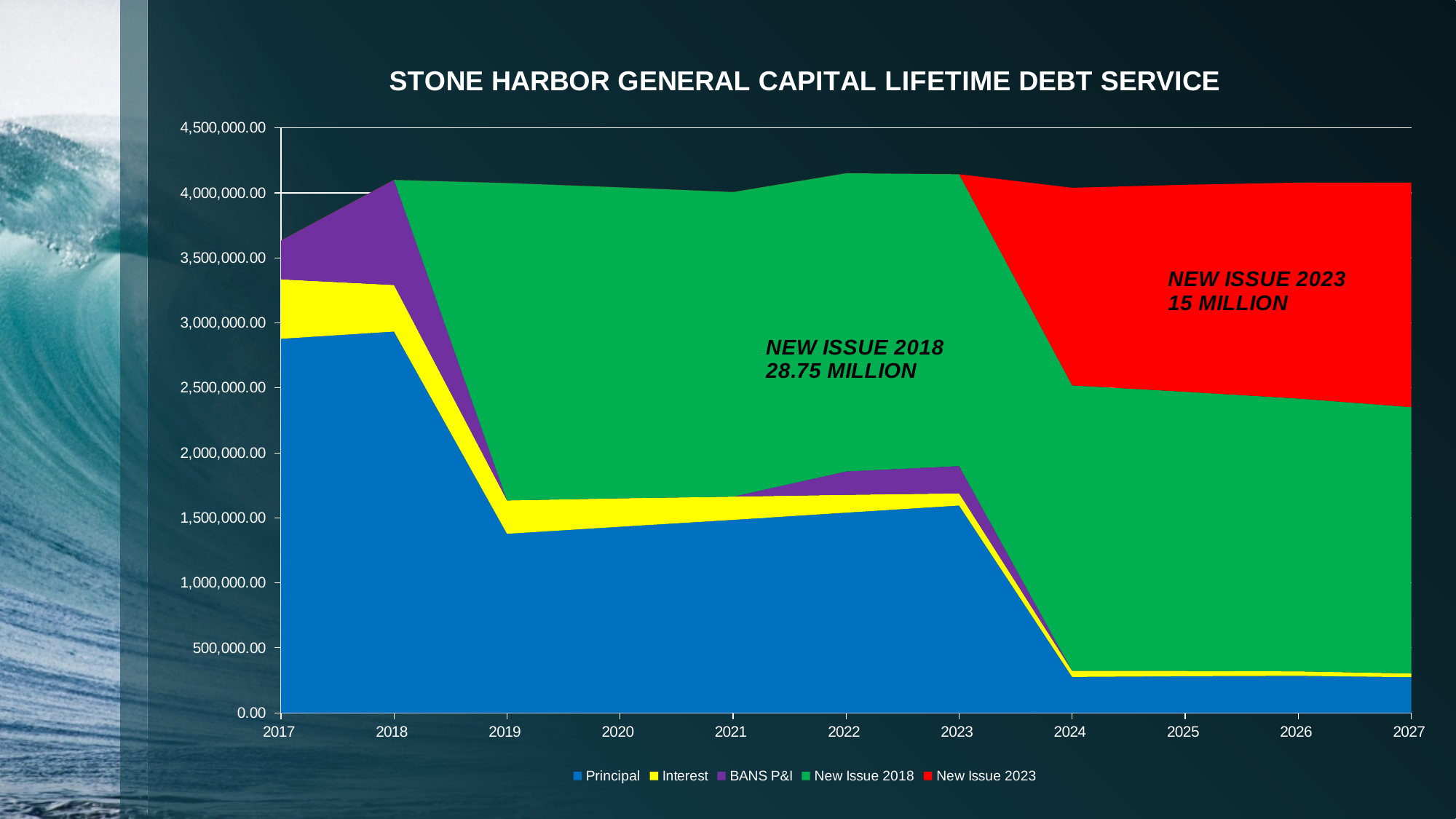
Is the total stacked value in 2017 greater or less than 4,000,000.00? less How many series does the legend list? 5 Is the value for Principal in 2024 greater or less than 500,000.00? less What kind of chart is shown on the slide? Area chart What is the title of the chart? STONE HARBOR GENERAL CAPITAL LIFETIME DEBT SERVICE Is the total stacked value in 2019 greater or less than 4,000,000.00? greater In which year does the New Issue 2023 series first appear in the chart? 2024 How many years are shown along the x axis? 11 What amount is annotated for the New Issue 2018 area? 28.75 MILLION Does the Principal series rise or fall overall from 2017 to 2027? Fall Which is larger, the Principal value in 2018 or in 2019? 2018